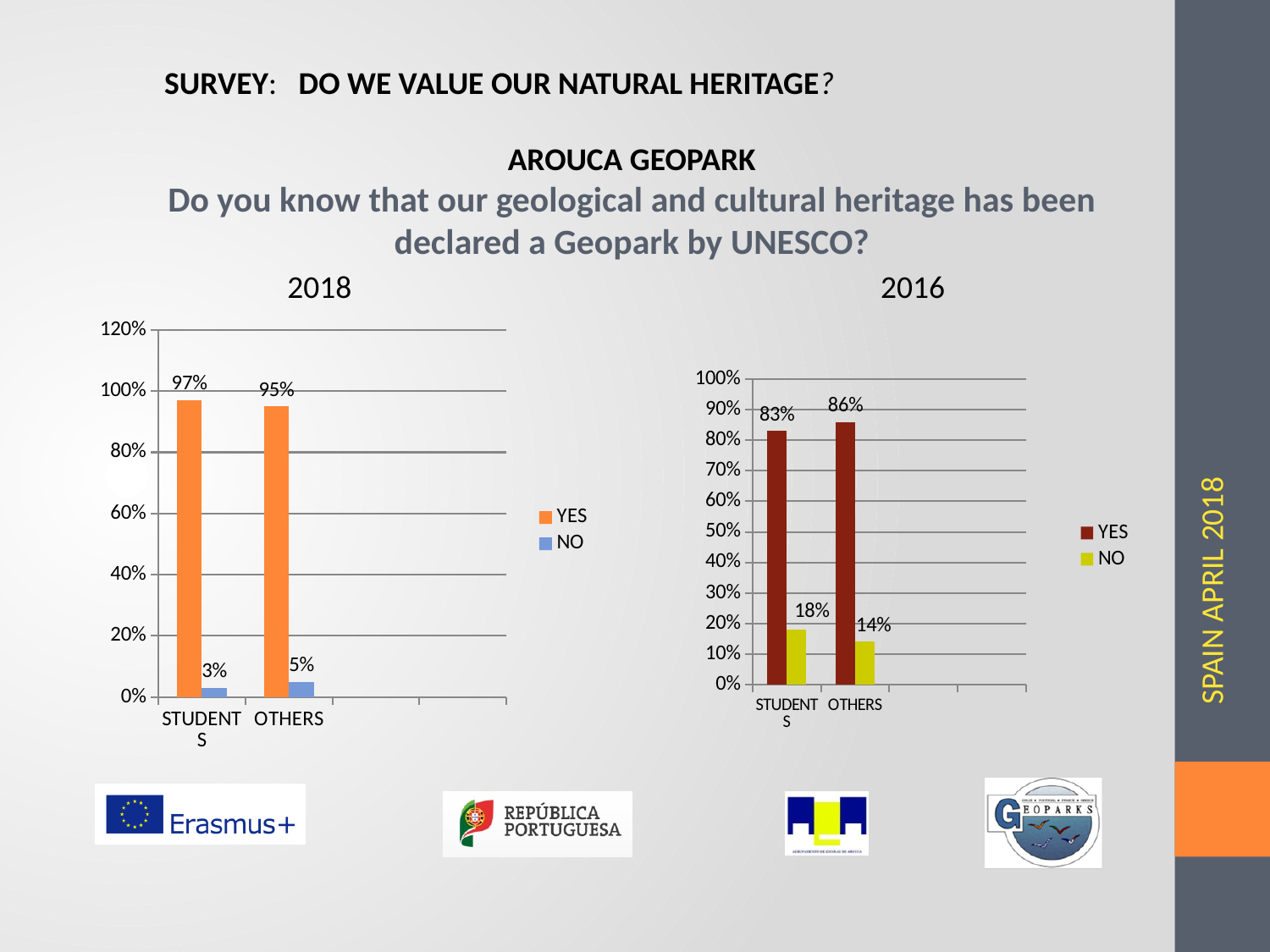
In the 2016 chart, which category has the higher NO value? STUDENTS In the 2018 chart, is the YES value for others larger than the YES value for students? No In the 2016 chart, is the YES value for students greater or less than 80%? greater In the 2016 chart, what percentage of students answered YES? 83% In the 2016 chart, what percentage of others answered NO? 14% What kind of chart is the 2016 chart? Bar chart In the 2016 chart, what is the difference between the NO values for students and others? 4% How many series does the legend of the 2018 chart list? 2 In the 2018 chart, what percentage of students answered YES? 97% In the 2018 chart, what is the difference between the YES values for students and others? 2% What colour are the YES bars in the 2018 chart? Orange In the 2018 chart, what percentage of others answered NO? 5%